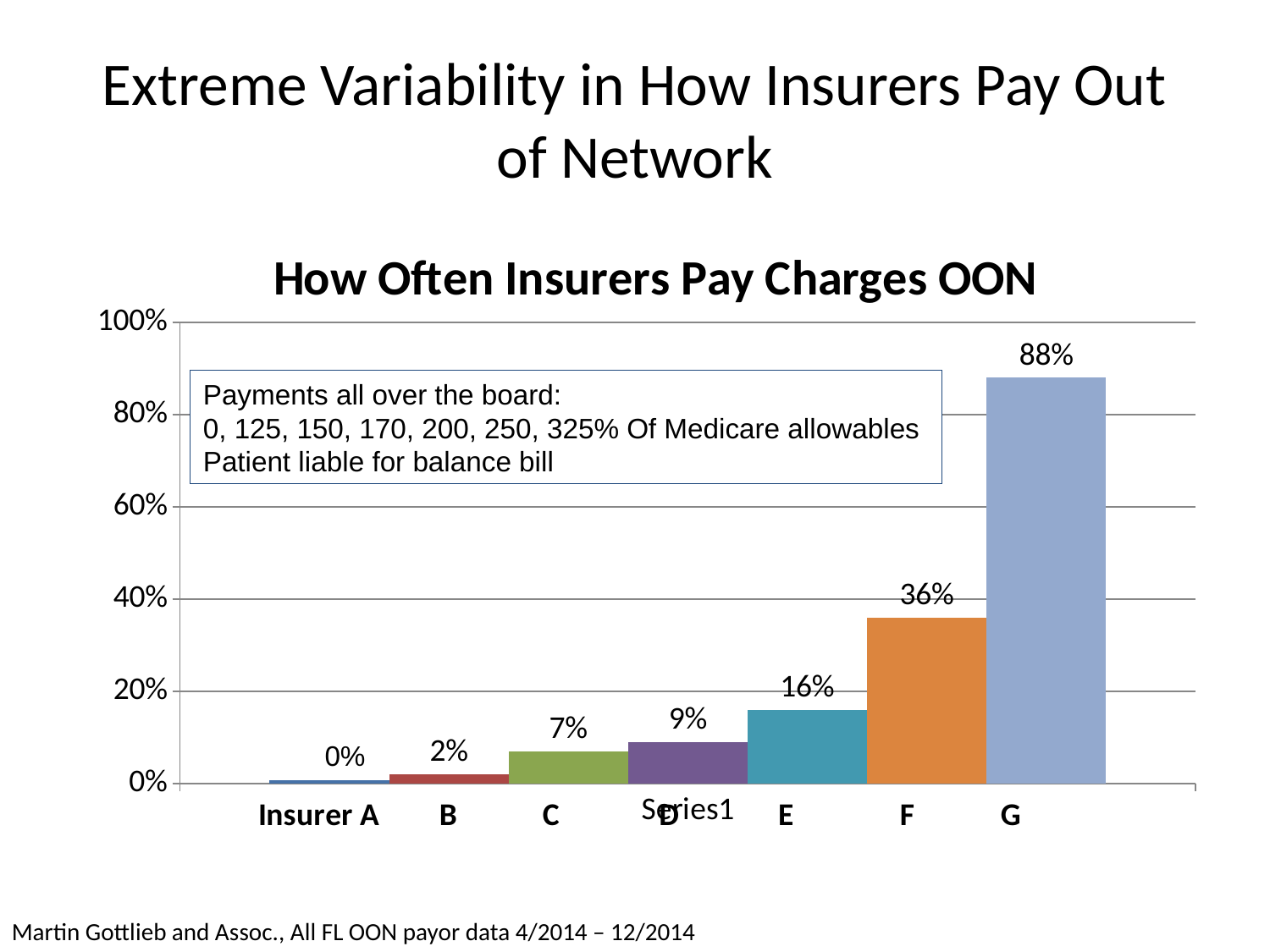
What is the value for Insurer G? 88% Is the value for Insurer F greater or less than 40%? less Which is larger, the value for Insurer D or Insurer E? E What is the value for Insurer F? 36% What is the value for Insurer E? 16% How many insurers are shown in the chart? 7 What is the value for Insurer C? 7% What kind of chart is shown on the slide? bar chart Which insurer has the lowest value? Insurer A Which insurer has the highest value? G What is the title of the chart? How Often Insurers Pay Charges OON What is the difference between the values for Insurer G and Insurer F? 52%